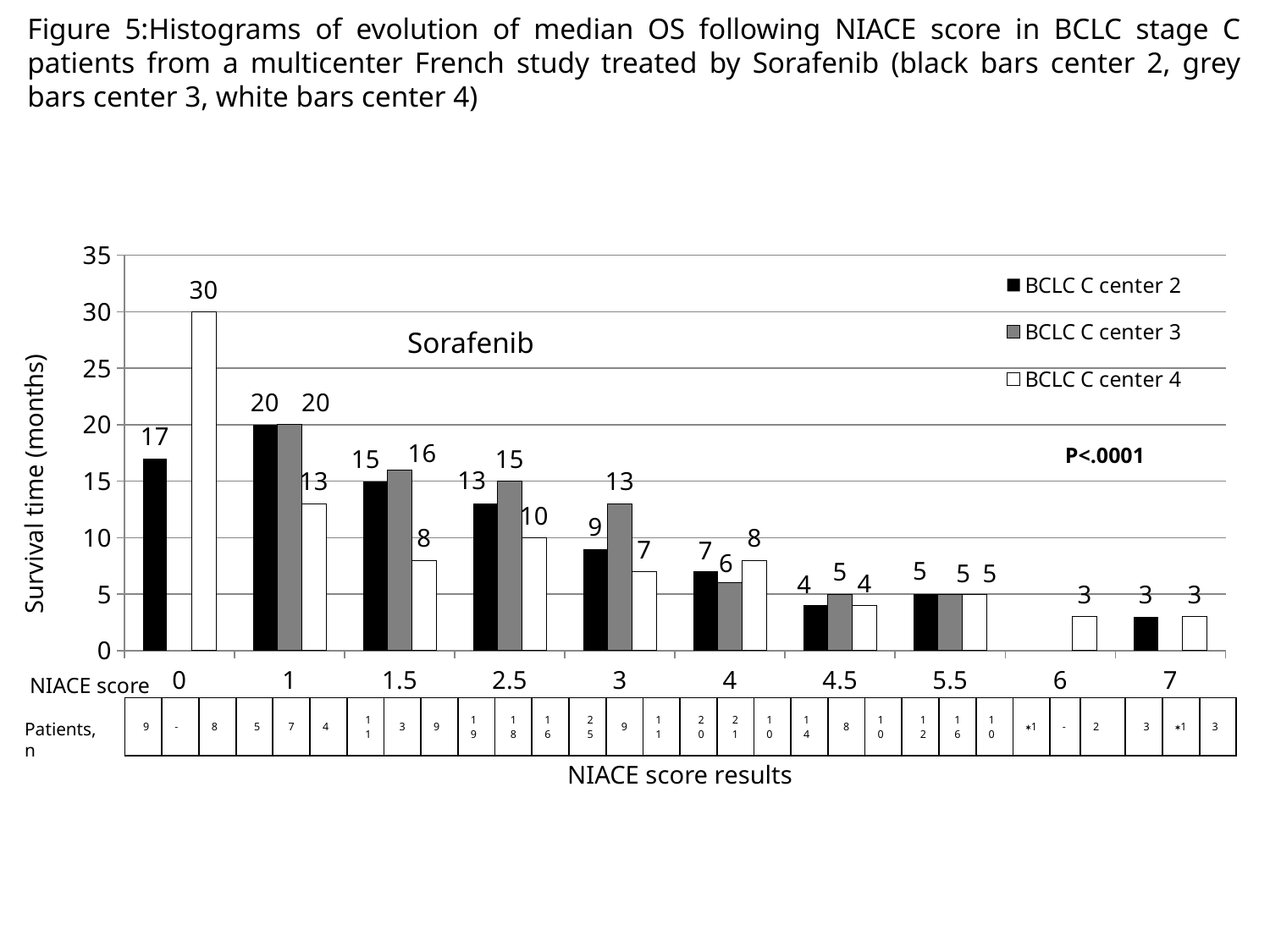
What is the difference between the BCLC C center 3 and BCLC C center 4 survival times at NIACE score 1.5? 8 At NIACE score 4, which is larger: the survival time for BCLC C center 2 or BCLC C center 3? BCLC C center 2 What is the survival time for BCLC C center 4 at NIACE score 0? 30 What kind of chart is shown on the slide? bar chart Do the survival times for BCLC C center 2 generally rise or fall as the NIACE score increases? fall How many series does the legend list? 3 What is the survival time for BCLC C center 2 at NIACE score 2.5? 13 What is the survival time for BCLC C center 3 at NIACE score 3? 13 Which NIACE score has the lowest survival time for BCLC C center 2? 7 Which NIACE score has the highest survival time for BCLC C center 4? 0 What is the title shown inside the chart area? Sorafenib How many NIACE score categories are shown on the x axis? 10